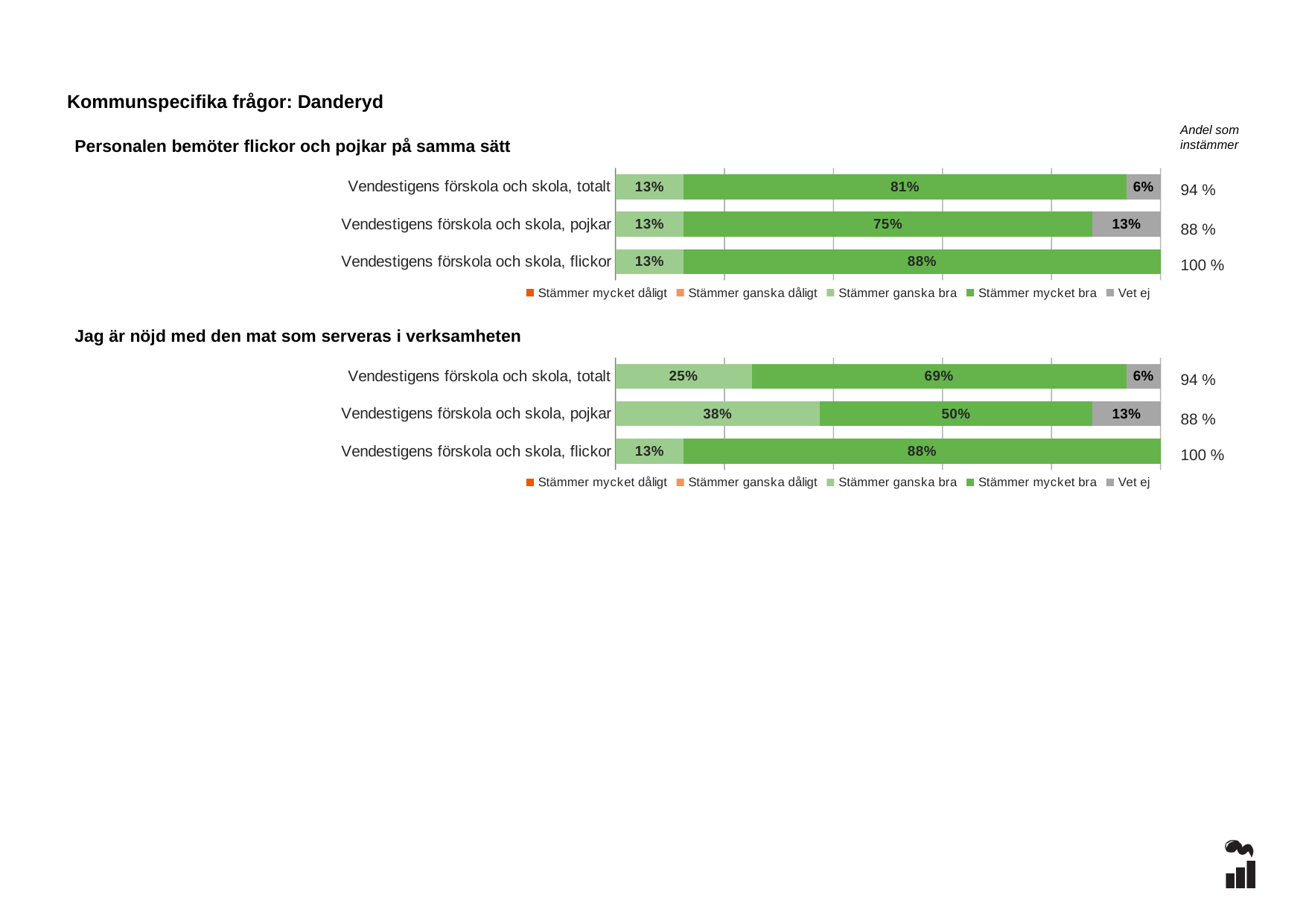
In the chart 'Jag är nöjd med den mat som serveras i verksamheten', what is the 'Andel som instämmer' value shown for 'Vendestigens förskola och skola, pojkar'? 88 % In the chart 'Jag är nöjd med den mat som serveras i verksamheten', what is the 'Stämmer ganska bra' value for 'Vendestigens förskola och skola, pojkar'? 38% In the chart 'Personalen bemöter flickor och pojkar på samma sätt', what is the 'Vet ej' value for 'Vendestigens förskola och skola, pojkar'? 13% In the chart 'Jag är nöjd med den mat som serveras i verksamheten', which category has the highest 'Stämmer mycket bra' value? Vendestigens förskola och skola, flickor In the chart 'Jag är nöjd med den mat som serveras i verksamheten', which category has the lowest 'Stämmer mycket bra' value? Vendestigens förskola och skola, pojkar In the chart 'Personalen bemöter flickor och pojkar på samma sätt', what is the difference between the 'Stämmer mycket bra' values for flickor and pojkar? 13% How many categories does the chart 'Personalen bemöter flickor och pojkar på samma sätt' show? 3 In the chart 'Jag är nöjd med den mat som serveras i verksamheten', what is the 'Stämmer mycket bra' value for 'Vendestigens förskola och skola, flickor'? 88% In the chart 'Personalen bemöter flickor och pojkar på samma sätt', what is the 'Stämmer mycket bra' value for 'Vendestigens förskola och skola, totalt'? 81% What kind of chart is 'Personalen bemöter flickor och pojkar på samma sätt'? Stacked bar chart In the chart 'Jag är nöjd med den mat som serveras i verksamheten', is the 'Stämmer ganska bra' value larger for totalt or for pojkar? pojkar How many series does the legend of the chart 'Jag är nöjd med den mat som serveras i verksamheten' list? 5